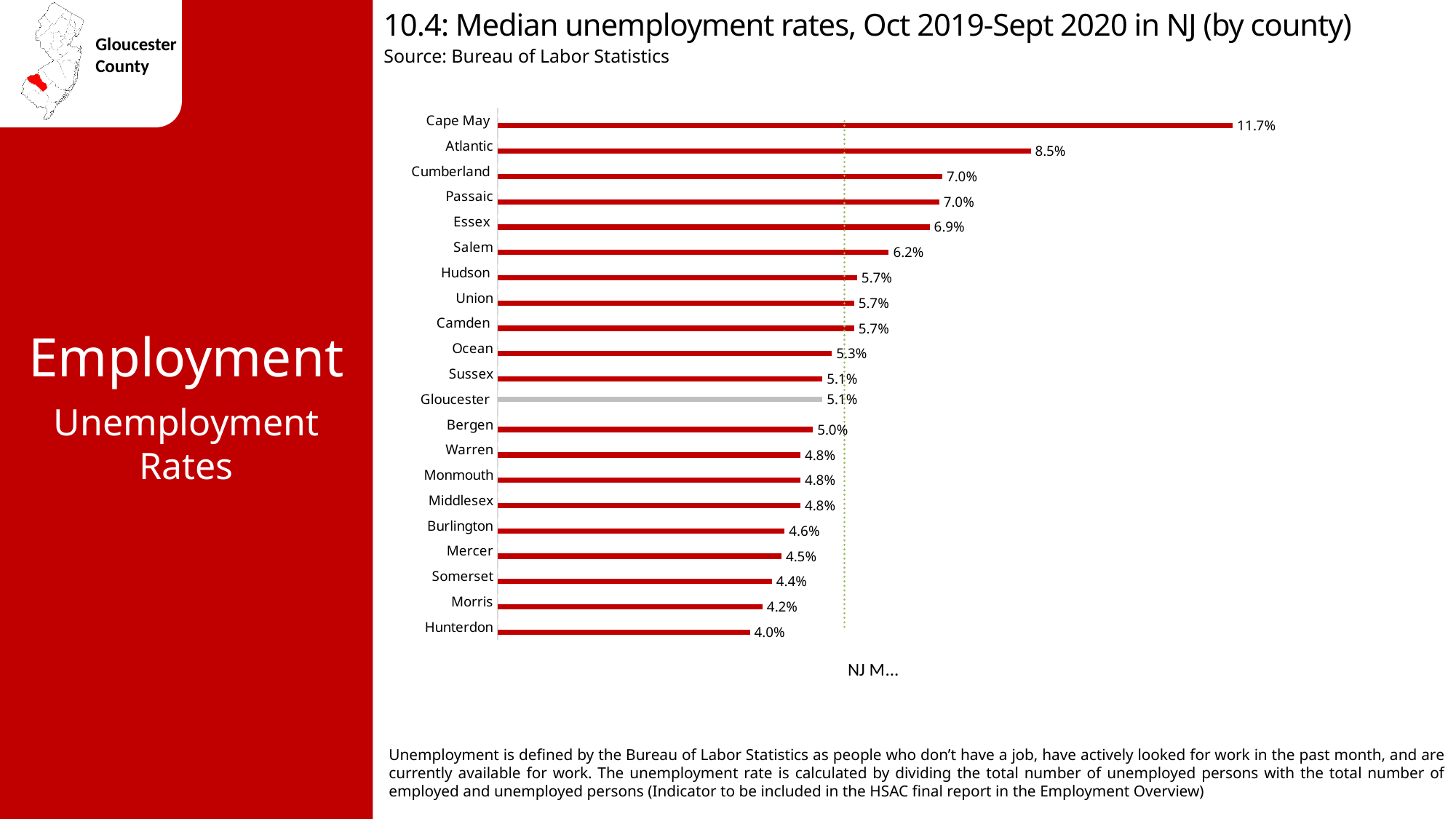
Which county's bar is shown in grey instead of red? Gloucester Which county has the highest median unemployment rate? Cape May What is the median unemployment rate for Hunterdon? 4.0% What is the difference between the median unemployment rates of Cape May and Atlantic? 3.2% Which county has a higher median unemployment rate, Salem or Ocean? Salem How many counties are shown in the chart? 21 What kind of chart is shown on the slide? Bar chart What is the median unemployment rate for Gloucester? 5.1% What is the difference between the median unemployment rates of Gloucester and Hunterdon? 1.1% What is the median unemployment rate for Essex? 6.9% What is the median unemployment rate for Cape May? 11.7% Which county has the lowest median unemployment rate? Hunterdon